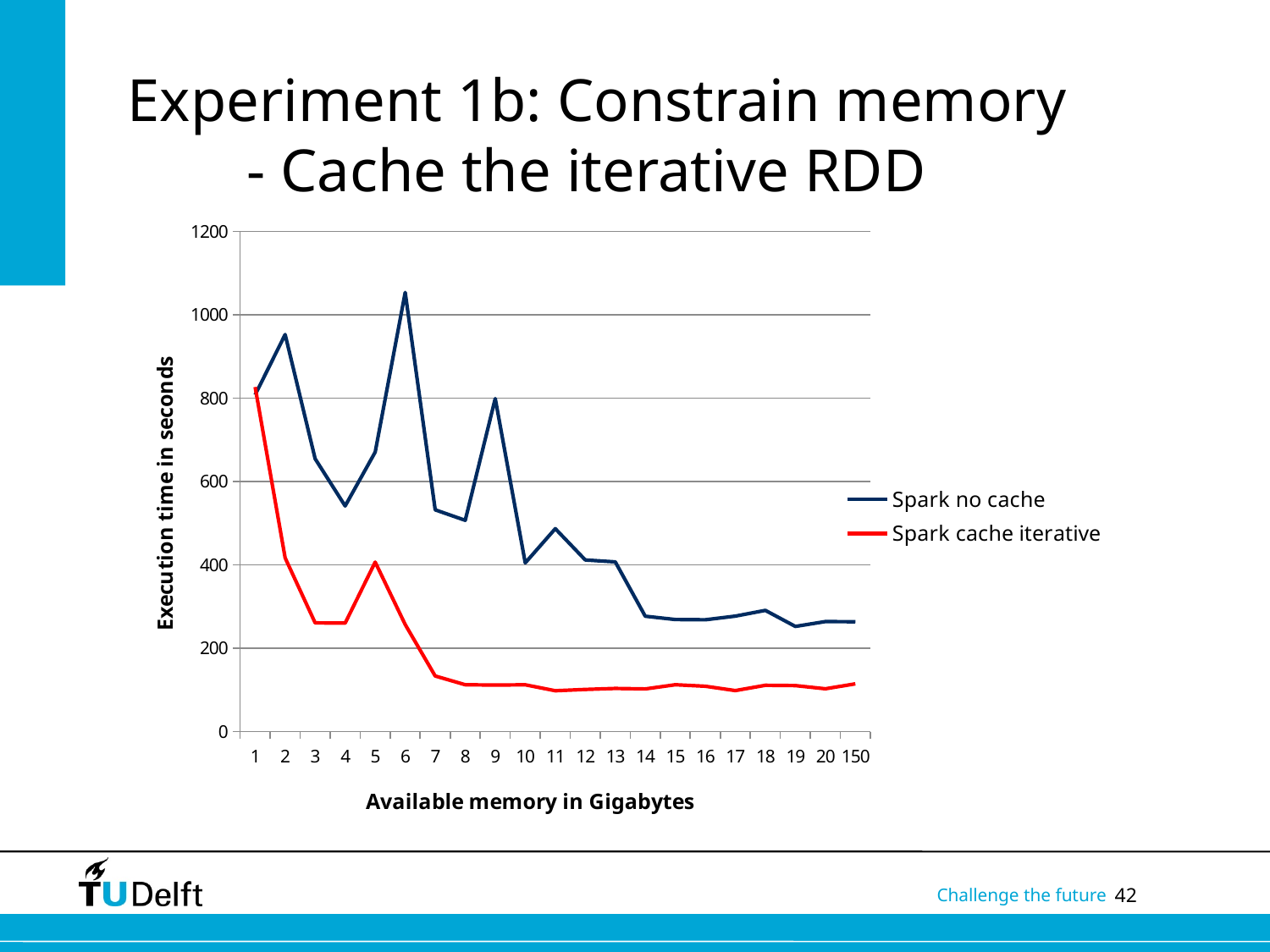
What is the label of the y axis? Execution time in seconds How many memory values are plotted along the x axis? 21 Is the Spark cache iterative value at 8 Gigabytes greater or less than 200? less At 6 Gigabytes of available memory, which series has the higher execution time, Spark no cache or Spark cache iterative? Spark no cache At which available memory value does the Spark cache iterative series reach its highest execution time? 1 How many series does the legend list? 2 What are the two series named in the legend? Spark no cache, Spark cache iterative Overall, does the execution time for Spark cache iterative rise or fall as available memory increases along the x axis? fall Is the Spark no cache value at 4 Gigabytes greater or less than 600? less What kind of chart is shown on the slide? line chart At which available memory value does the Spark no cache series reach its highest execution time? 6 Is the Spark no cache value at 6 Gigabytes greater or less than 1000? greater